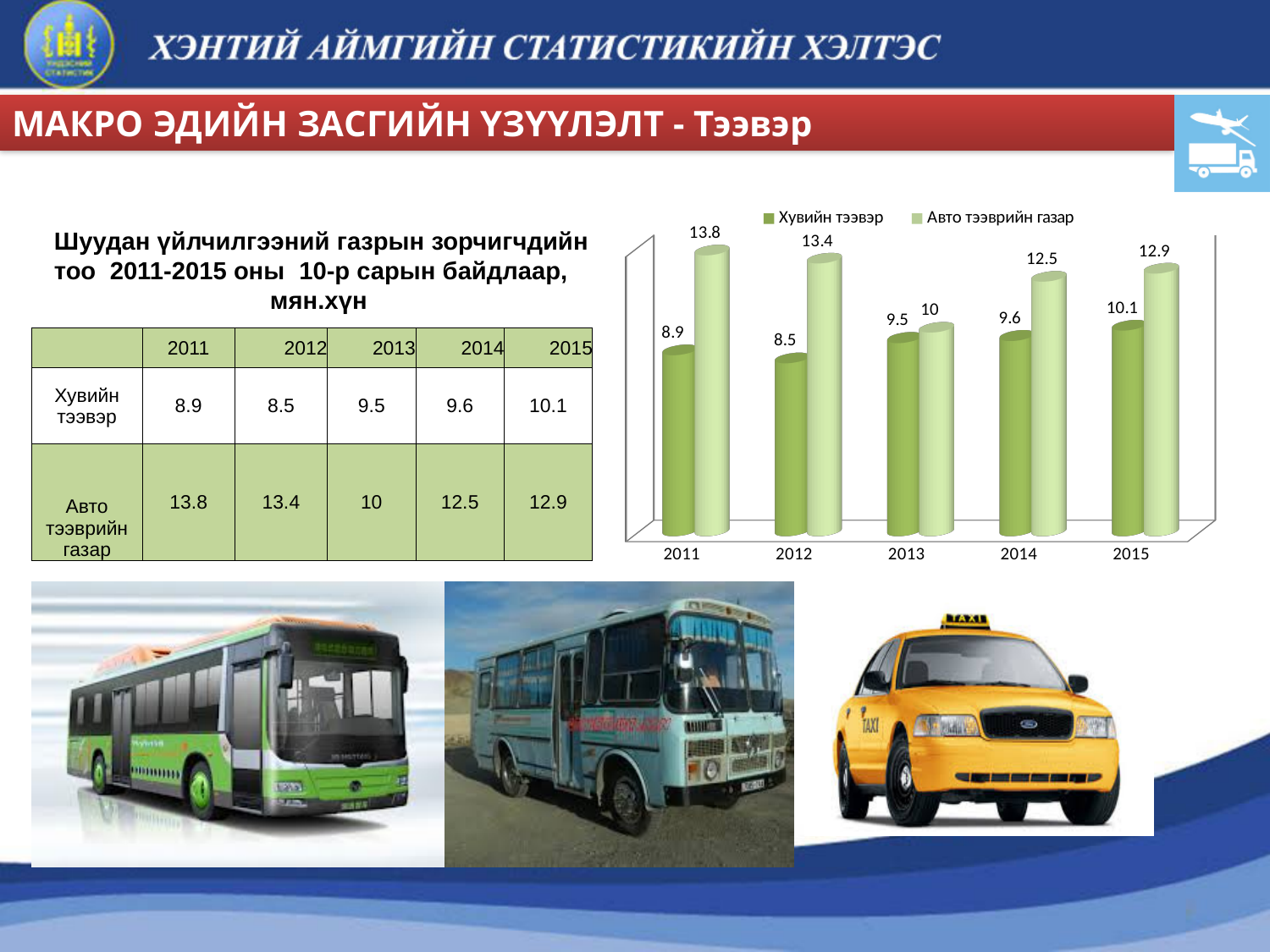
In which year is the value for Авто тээврийн газар the highest? 2011 In which year is the value for Хувийн тээвэр the lowest? 2012 What is the value for Авто тээврийн газар in 2011? 13.8 How many years are shown on the x axis of the chart? 5 What is the difference between the Авто тээврийн газар values in 2011 and 2013? 3.8 What is the value for Хувийн тээвэр in 2013? 9.5 What kind of chart is shown on the slide? Bar chart What is the difference between Авто тээврийн газар and Хувийн тээвэр in 2015? 2.8 How many series does the chart legend list? 2 Which series has the larger value in 2013, Хувийн тээвэр or Авто тээврийн газар? Авто тээврийн газар What is the value for Авто тээврийн газар in 2014? 12.5 Does the value for Хувийн тээвэр rise or fall from 2012 to 2015? Rise